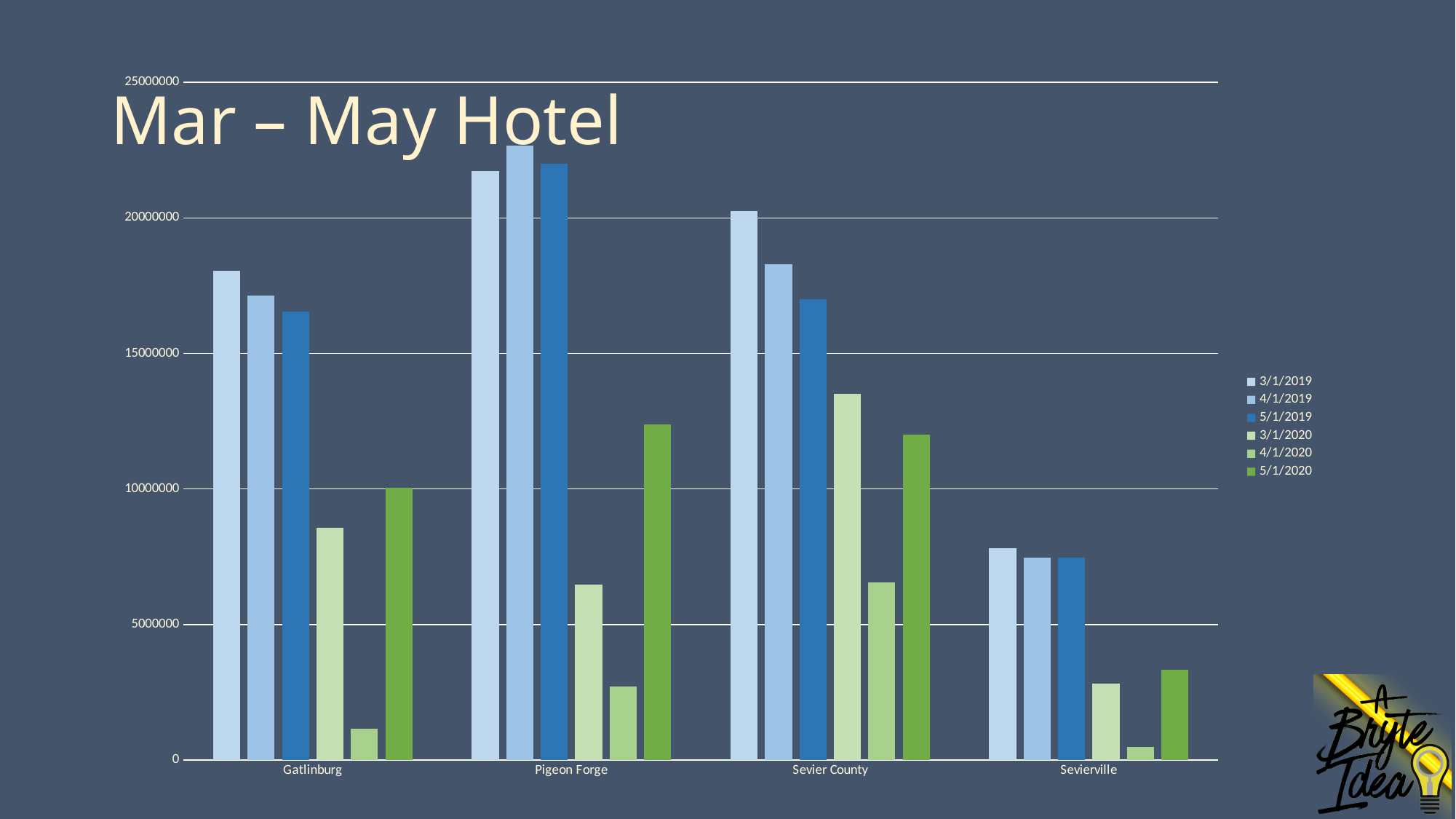
Which is larger for Gatlinburg: the 3/1/2019 value or the 3/1/2020 value? 3/1/2019 Which category has the larger 5/1/2020 value: Gatlinburg or Sevier County? Sevier County How many categories are shown on the x axis of the chart? 4 Is the 3/1/2020 value for Sevier County greater or less than 15000000? less Which category has the lowest 3/1/2019 value? Sevierville How many series does the chart's legend list? 6 Is the 3/1/2019 value for Gatlinburg greater or less than 15000000? greater Is the 4/1/2020 value for Gatlinburg greater or less than 5000000? less What is the title of the chart on the slide? Mar – May Hotel What kind of chart is shown on the slide? bar chart Which category has the highest 3/1/2019 value? Pigeon Forge